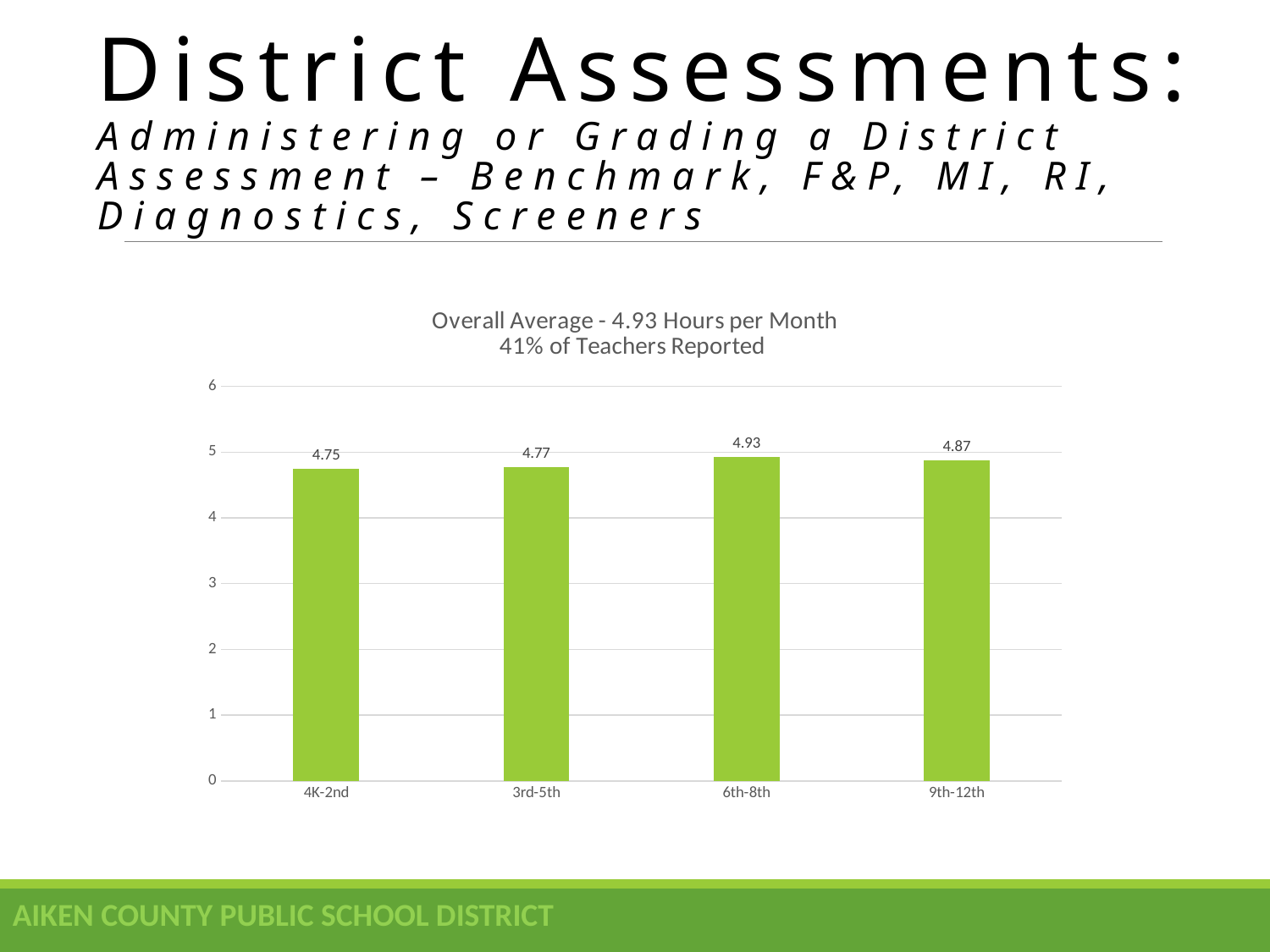
How many grade bands are shown on the chart? 4 What is the value for 4K-2nd? 4.75 Which grade band has the highest value? 6th-8th Is the value for 6th-8th greater or less than 5? less Which is larger, the value for 9th-12th or the value for 3rd-5th? 9th-12th What is the difference between the values for 6th-8th and 4K-2nd? 0.18 According to the chart title, what is the overall average in hours per month? 4.93 Hours per Month Which grade band has the lowest value? 4K-2nd What is the value for 9th-12th? 4.87 What kind of chart is shown on the slide? bar chart What is the value for 6th-8th? 4.93 What is the value for 3rd-5th? 4.77